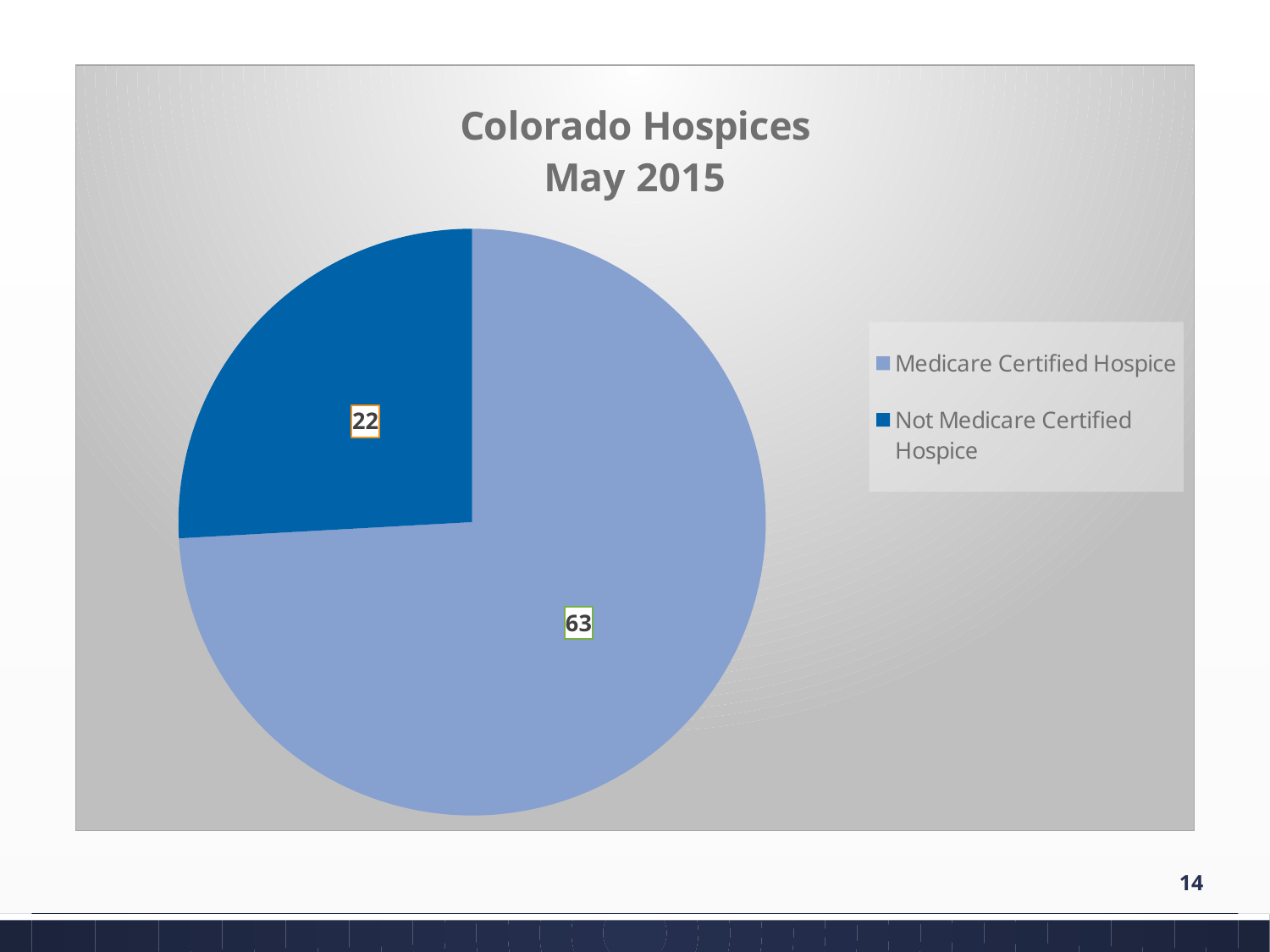
Which category has the smallest slice of the pie? Not Medicare Certified Hospice How many entries does the legend list? 2 What is the title of the chart? Colorado Hospices May 2015 How many hospices are Medicare Certified Hospice? 63 How many slices does the pie chart have? 2 Which legend entry is shown in the darker blue colour? Not Medicare Certified Hospice Which is larger, Medicare Certified Hospice or Not Medicare Certified Hospice? Medicare Certified Hospice Which category has the largest slice of the pie? Medicare Certified Hospice What is the difference between the Medicare Certified Hospice and Not Medicare Certified Hospice values? 41 What kind of chart is shown on the slide? pie chart How many hospices are Not Medicare Certified Hospice? 22 What is the total of all slices in the pie chart? 85